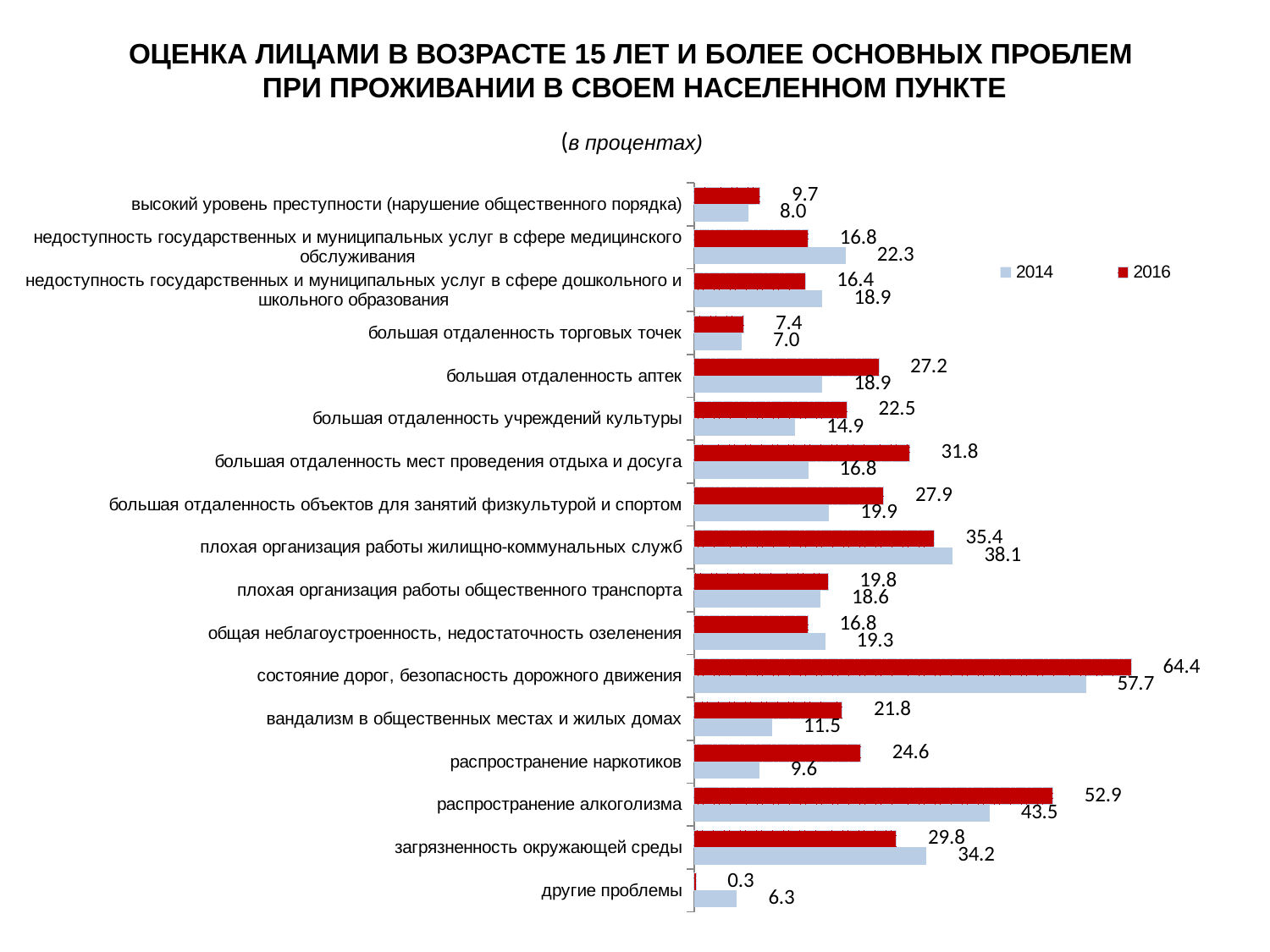
Which is larger for «загрязненность окружающей среды»: the 2014 value or the 2016 value? 2014 What is the difference between the 2016 and 2014 values for «вандализм в общественных местах и жилых домах»? 10.3 What is the 2014 value for «плохая организация работы жилищно-коммунальных служб»? 38.1 What is the 2016 value for «состояние дорог, безопасность дорожного движения»? 64.4 What is the 2014 value for «распространение алкоголизма»? 43.5 Which category has the highest 2016 value? состояние дорог, безопасность дорожного движения How many series does the legend list? 2 What kind of chart is shown on the slide? bar chart Which category has the lowest 2016 value? другие проблемы Which colour represents the 2016 series in the chart? red How many categories are shown in the chart? 17 What is the 2016 value for «распространение наркотиков»? 24.6